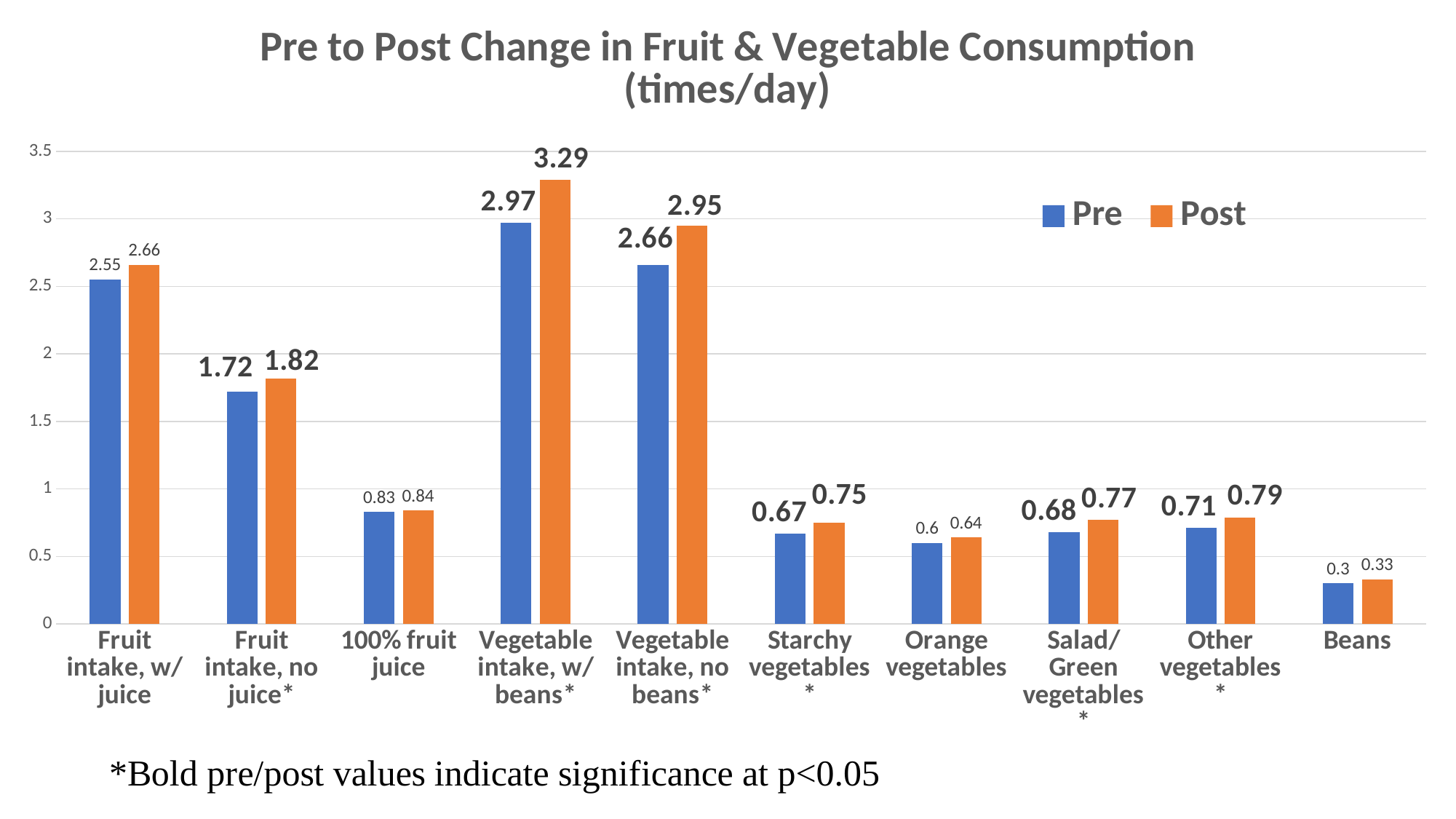
Which category has the lowest Pre value? Beans What is the difference between the Post and Pre values for Vegetable intake, no beans? 0.29 Which is larger, the Post value for Starchy vegetables or the Post value for Orange vegetables? Starchy vegetables How many categories are shown on the x axis? 10 How many series does the legend list? 2 What is the Pre value for Beans? 0.3 What is the Pre value for Fruit intake, no juice? 1.72 Is the Pre value for Fruit intake, w/ juice greater or less than 2? greater What kind of chart is this? Bar chart What is the Post value for Vegetable intake, w/ beans? 3.29 What colour represents the Post series? Orange Which category has the highest Post value? Vegetable intake, w/ beans